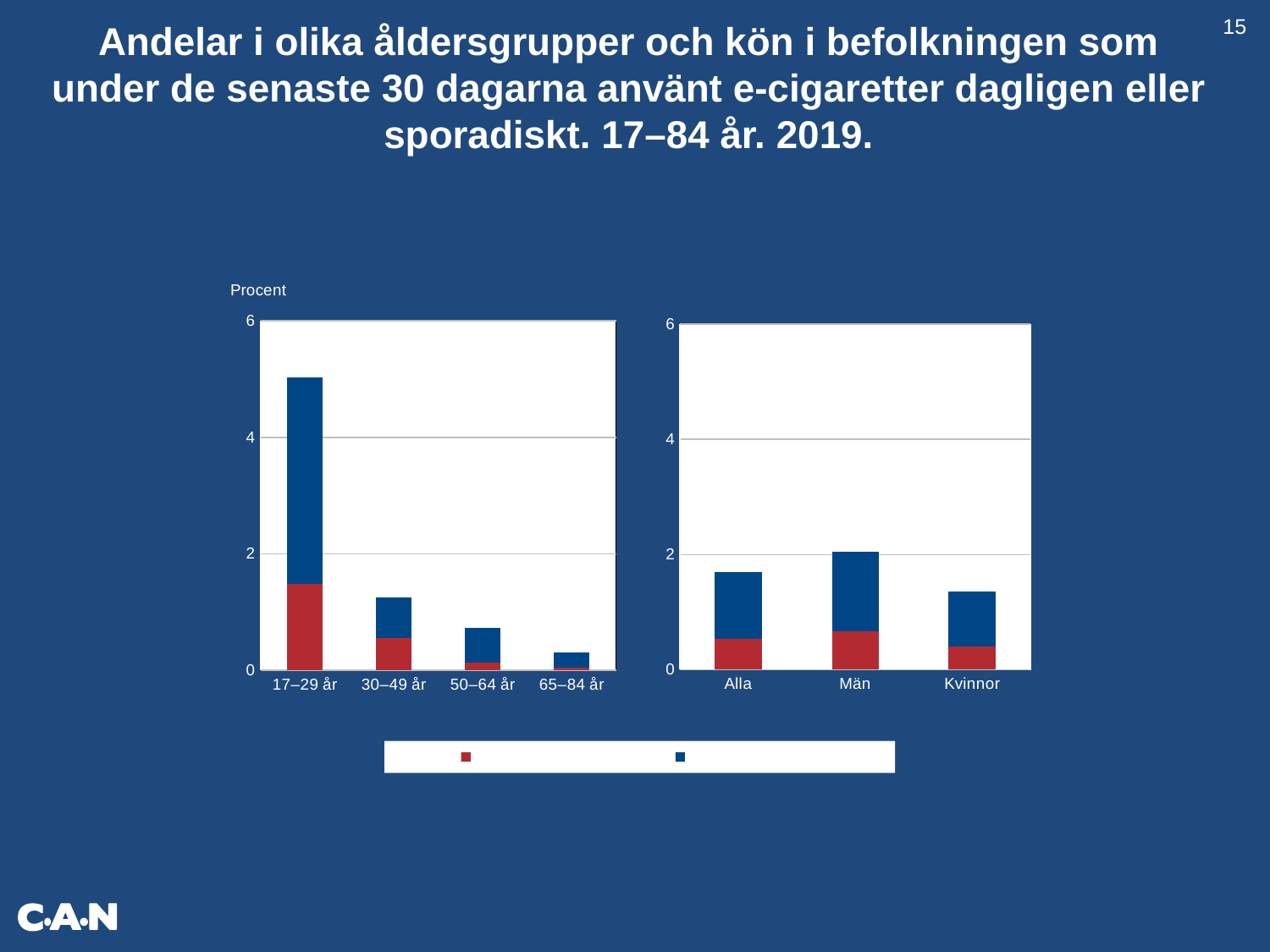
On the left chart, do the total bar values rise or fall as age group increases along the x axis? fall On the right chart, which is larger, the total bar for Män or for Kvinnor? Män How many categories are shown on the right chart (Alla, Män, Kvinnor)? 3 What kind of chart is the left chart (by age group)? stacked bar chart What label is shown above the left chart's vertical axis? Procent On the left chart, is the total value for 17–29 år greater or less than 4? greater On the left chart, is the total value for 30–49 år greater or less than 2? less How many age-group categories are shown on the left chart? 4 How many series does the legend below the charts list? 2 On the right chart, is the total value for Kvinnor greater or less than 2? less On the left chart, which age group has the highest total bar? 17–29 år On the left chart, which age group has the lowest total bar? 65–84 år